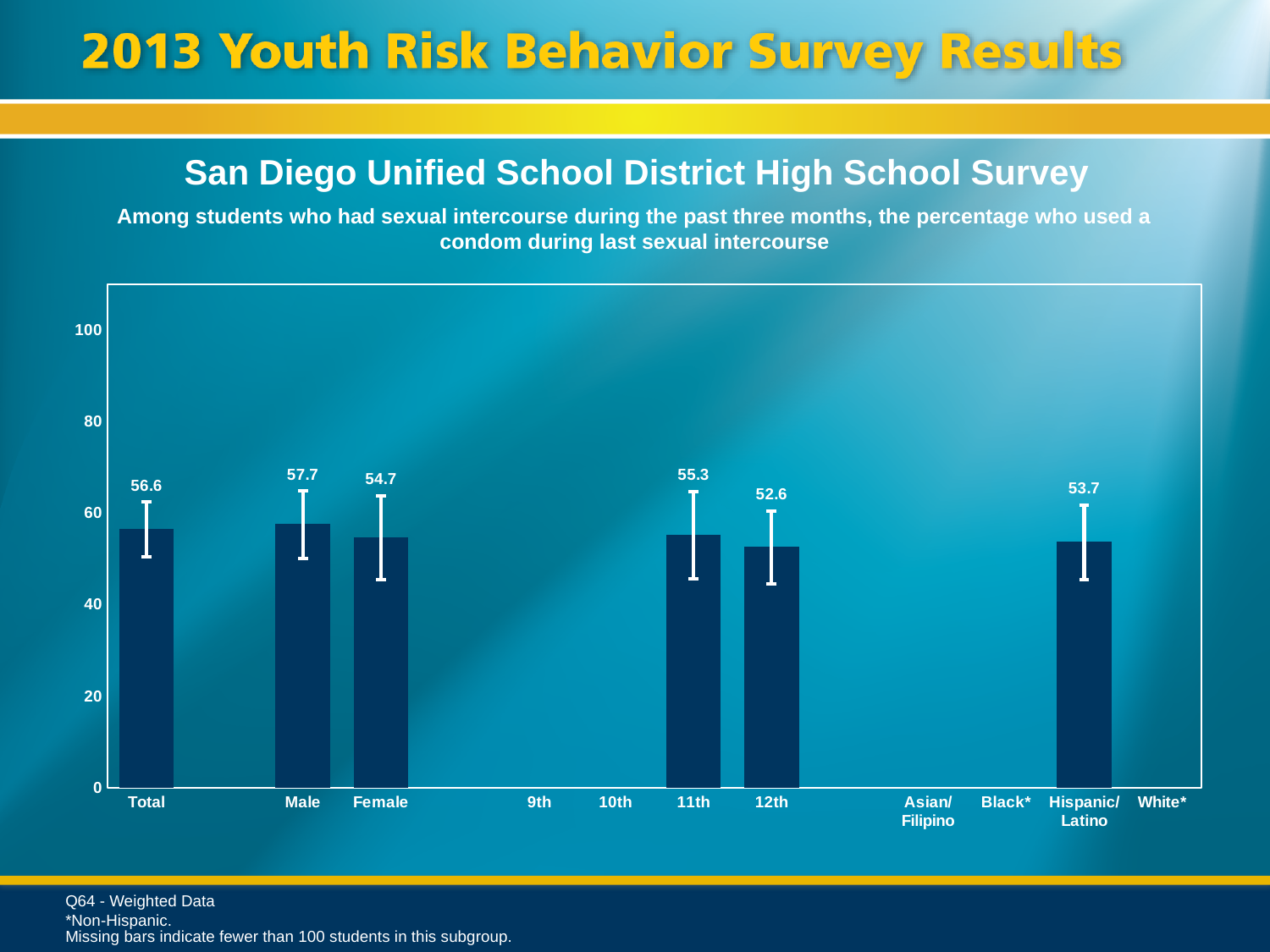
What kind of chart is shown on the slide? bar chart How many bars are plotted on the chart? 6 Which category has the highest plotted value? Male What is the value for Total? 56.6 Is the value for Total greater or less than 60? less What is the value for Male? 57.7 What is the value for Female? 54.7 What is the value for Hispanic/Latino? 53.7 Which is larger, the value for 11th or the value for 12th? 11th What is the value for 12th? 52.6 Which category has the lowest plotted value? 12th What is the difference between the Male and Female values? 3.0